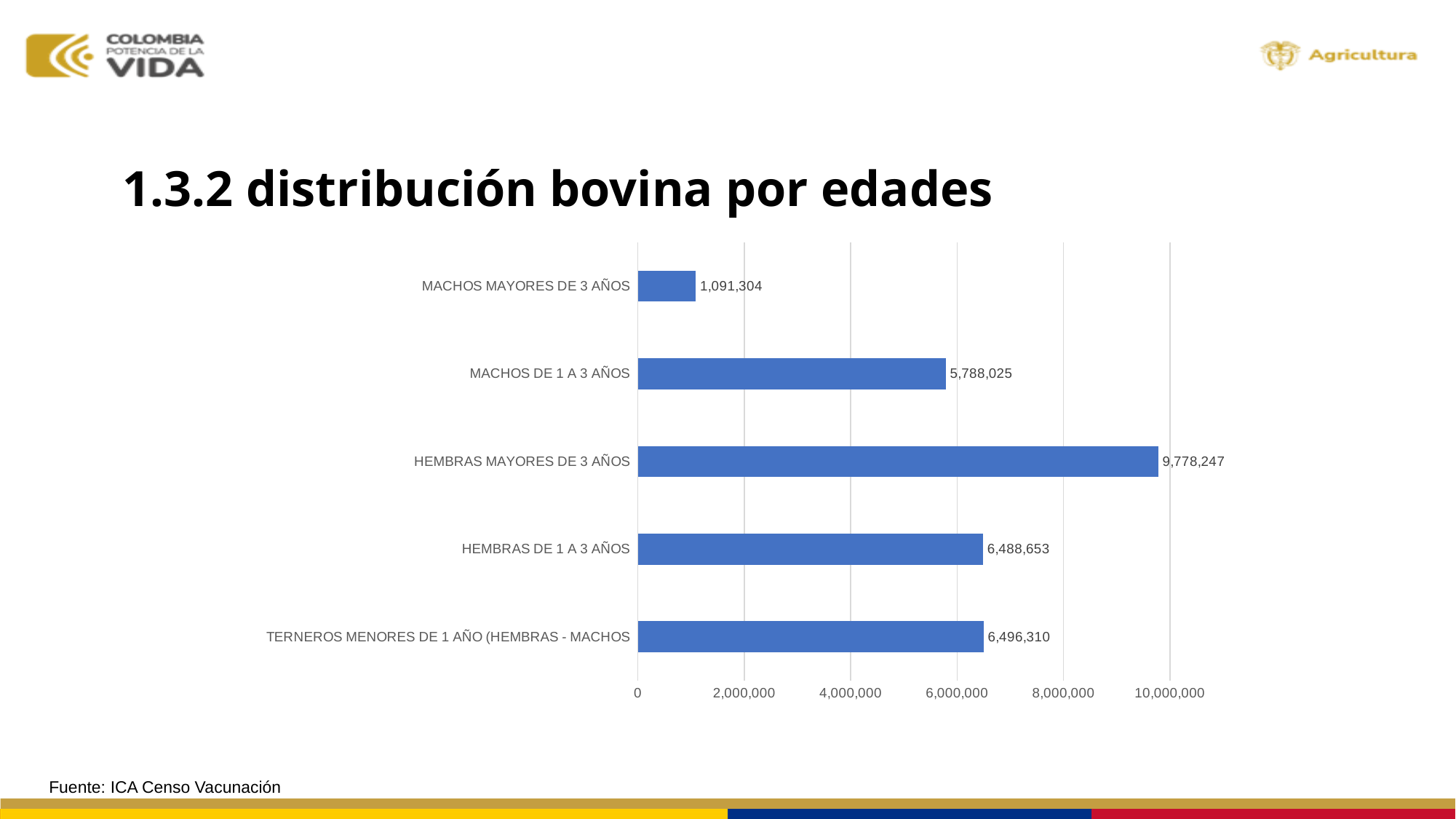
Which category has the lowest value? MACHOS MAYORES DE 3 AÑOS How many categories are shown in the chart? 5 What source is cited for the chart data? ICA Censo Vacunación Which is larger, HEMBRAS DE 1 A 3 AÑOS or MACHOS DE 1 A 3 AÑOS? HEMBRAS DE 1 A 3 AÑOS What is the difference between HEMBRAS DE 1 A 3 AÑOS and MACHOS DE 1 A 3 AÑOS? 700,628 Is the value for MACHOS DE 1 A 3 AÑOS greater or less than 6,000,000? less What is the value for TERNEROS MENORES DE 1 AÑO (HEMBRAS - MACHOS)? 6,496,310 What is the difference between HEMBRAS MAYORES DE 3 AÑOS and MACHOS MAYORES DE 3 AÑOS? 8,686,943 What kind of chart is shown on the slide? bar chart What is the value for MACHOS DE 1 A 3 AÑOS? 5,788,025 Which category has the highest value? HEMBRAS MAYORES DE 3 AÑOS What is the value for HEMBRAS MAYORES DE 3 AÑOS? 9,778,247